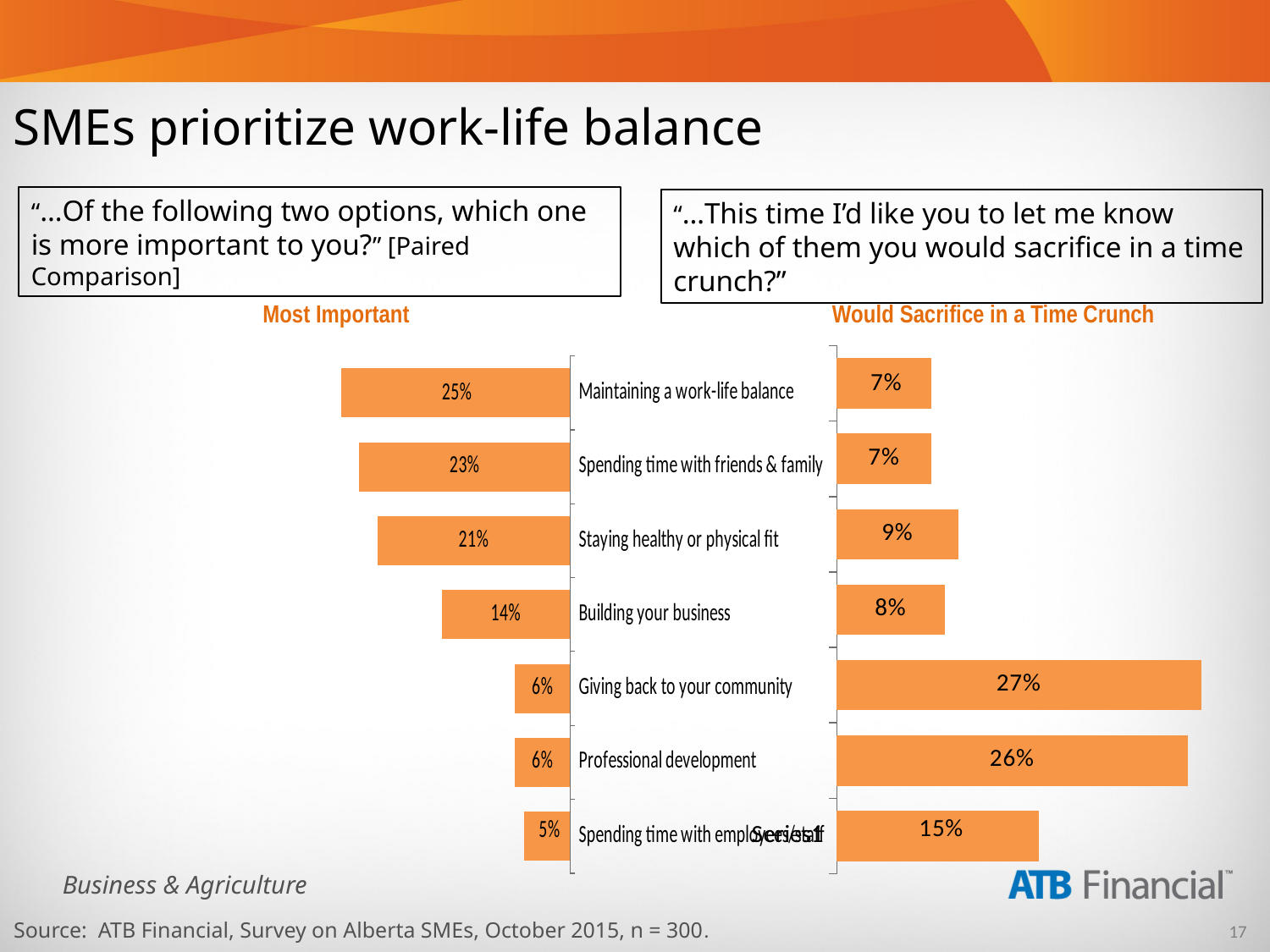
In the 'Most Important' chart, what is the difference between Maintaining a work-life balance and Building your business? 11 percentage points In the 'Would Sacrifice in a Time Crunch' chart, what is the value for Staying healthy or physical fit? 9% In the 'Would Sacrifice in a Time Crunch' chart, what is the difference between Giving back to your community and Professional development? 1 percentage point In the 'Most Important' chart, what is the value for Building your business? 14% In the 'Most Important' chart, what is the value for Maintaining a work-life balance? 25% How many categories are shown in the 'Most Important' chart? 7 What type of chart is the 'Would Sacrifice in a Time Crunch' chart? Bar chart In the 'Would Sacrifice in a Time Crunch' chart, what is the value for Giving back to your community? 27% In the 'Most Important' chart, which is larger: Spending time with friends & family or Staying healthy or physical fit? Spending time with friends & family In the 'Most Important' chart, which category has the highest value? Maintaining a work-life balance In the 'Would Sacrifice in a Time Crunch' chart, which is larger: Staying healthy or physical fit, or Building your business? Staying healthy or physical fit In the 'Would Sacrifice in a Time Crunch' chart, which category has the highest value? Giving back to your community